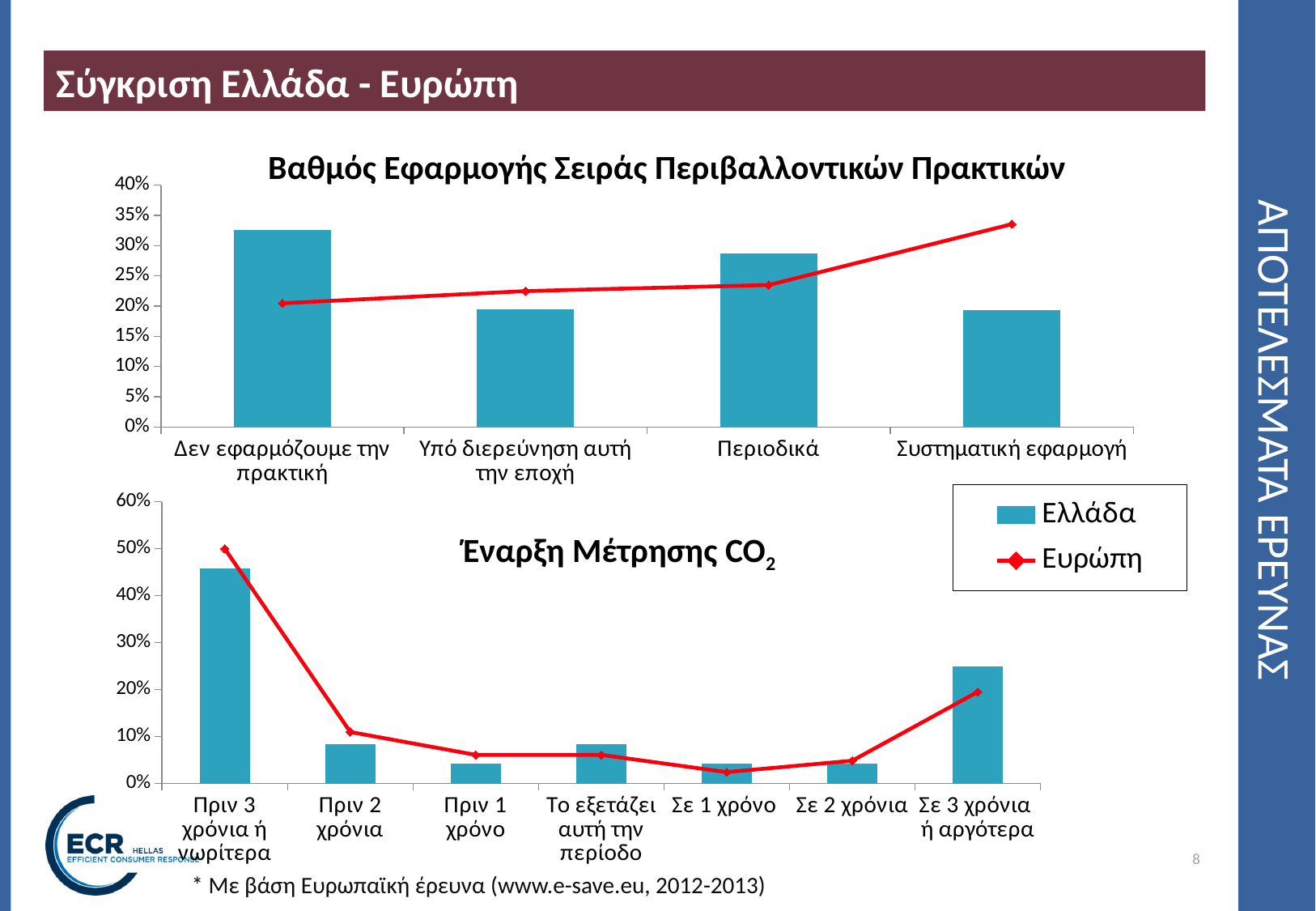
In the bottom chart 'Έναρξη Μέτρησης CO2', which is larger for 'Σε 3 χρόνια ή αργότερα': Ελλάδα or Ευρώπη? Ελλάδα How many categories are shown on the x axis of the bottom chart 'Έναρξη Μέτρησης CO2'? 7 In the top chart 'Βαθμός Εφαρμογής Σειράς Περιβαλλοντικών Πρακτικών', which category has the highest value for Ελλάδα? Δεν εφαρμόζουμε την πρακτική What colour are the Ελλάδα bars in the charts? Teal blue In the bottom chart 'Έναρξη Μέτρησης CO2', which category has the highest value for Ελλάδα? Πριν 3 χρόνια ή νωρίτερα In the bottom chart 'Έναρξη Μέτρησης CO2', is the Ελλάδα value for 'Πριν 3 χρόνια ή νωρίτερα' greater or less than 40%? greater In the top chart 'Βαθμός Εφαρμογής Σειράς Περιβαλλοντικών Πρακτικών', does the Ευρώπη line rise or fall from left to right? Rises How many series does the legend list? 2 In the top chart 'Βαθμός Εφαρμογής Σειράς Περιβαλλοντικών Πρακτικών', which category has the highest value for Ευρώπη? Συστηματική εφαρμογή In the top chart 'Βαθμός Εφαρμογής Σειράς Περιβαλλοντικών Πρακτικών', is the Ελλάδα value for 'Δεν εφαρμόζουμε την πρακτική' greater or less than 30%? greater What type of chart is the top chart titled 'Βαθμός Εφαρμογής Σειράς Περιβαλλοντικών Πρακτικών'? Combined bar and line chart In the top chart 'Βαθμός Εφαρμογής Σειράς Περιβαλλοντικών Πρακτικών', which is larger for 'Συστηματική εφαρμογή': Ελλάδα or Ευρώπη? Ευρώπη